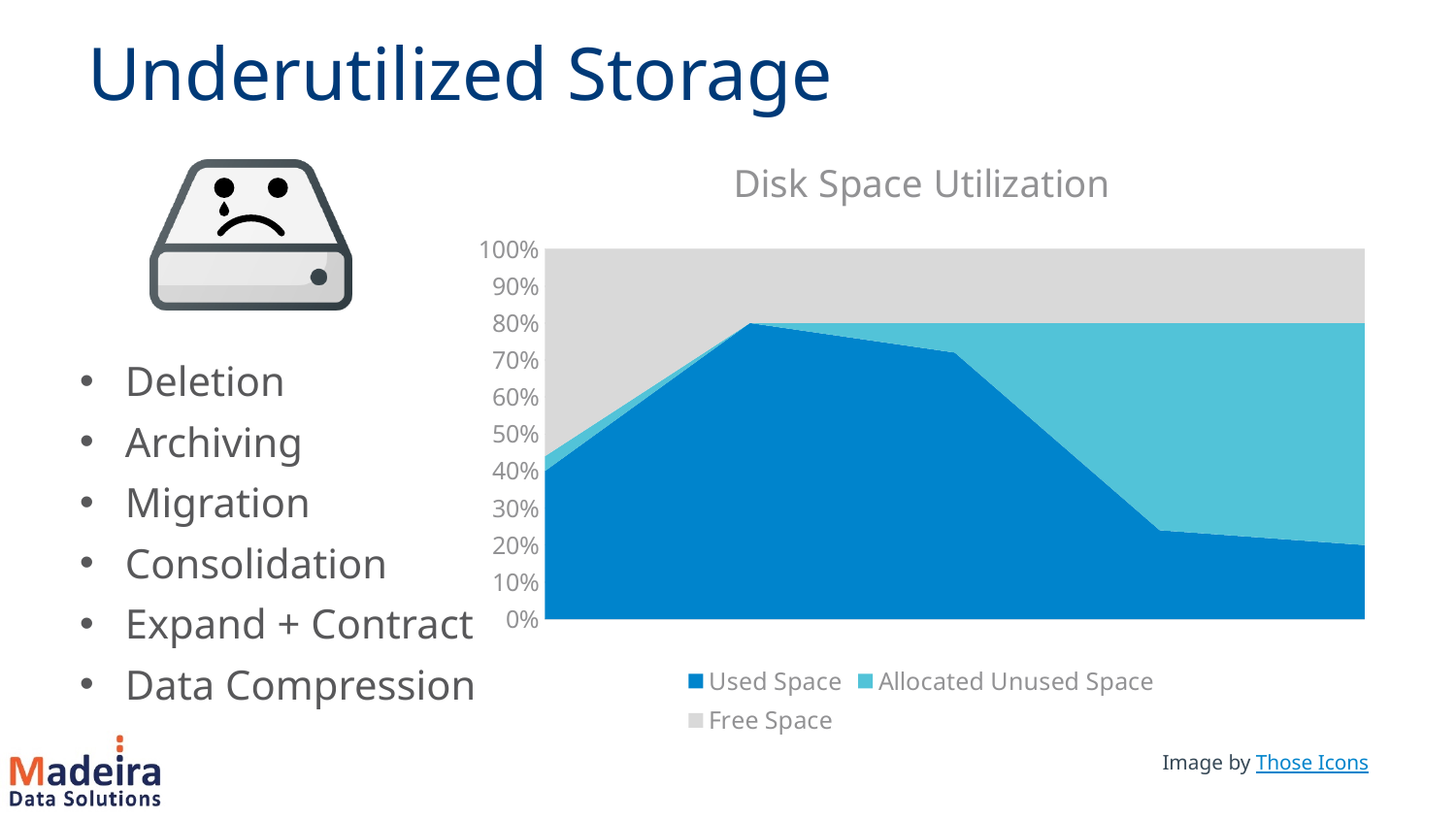
Is the value of Used Space at the left end of the chart greater or less than 60%? less Is the value of Used Space at the right end of the chart greater or less than 40%? less What is the title of the chart? Disk Space Utilization What kind of chart is shown on the slide? Area chart Is the Free Space share at the right end of the chart greater or less than 40%? less Does the Used Space series rise or fall from its peak to the right end of the chart? Fall How many data points does each series in the chart have? 5 Which series occupies the largest share at the right end of the chart? Allocated Unused Space Which series are listed in the chart's legend? Used Space, Allocated Unused Space, Free Space At the left end of the chart, which is larger: Used Space or Free Space? Free Space How many series does the chart's legend list? 3